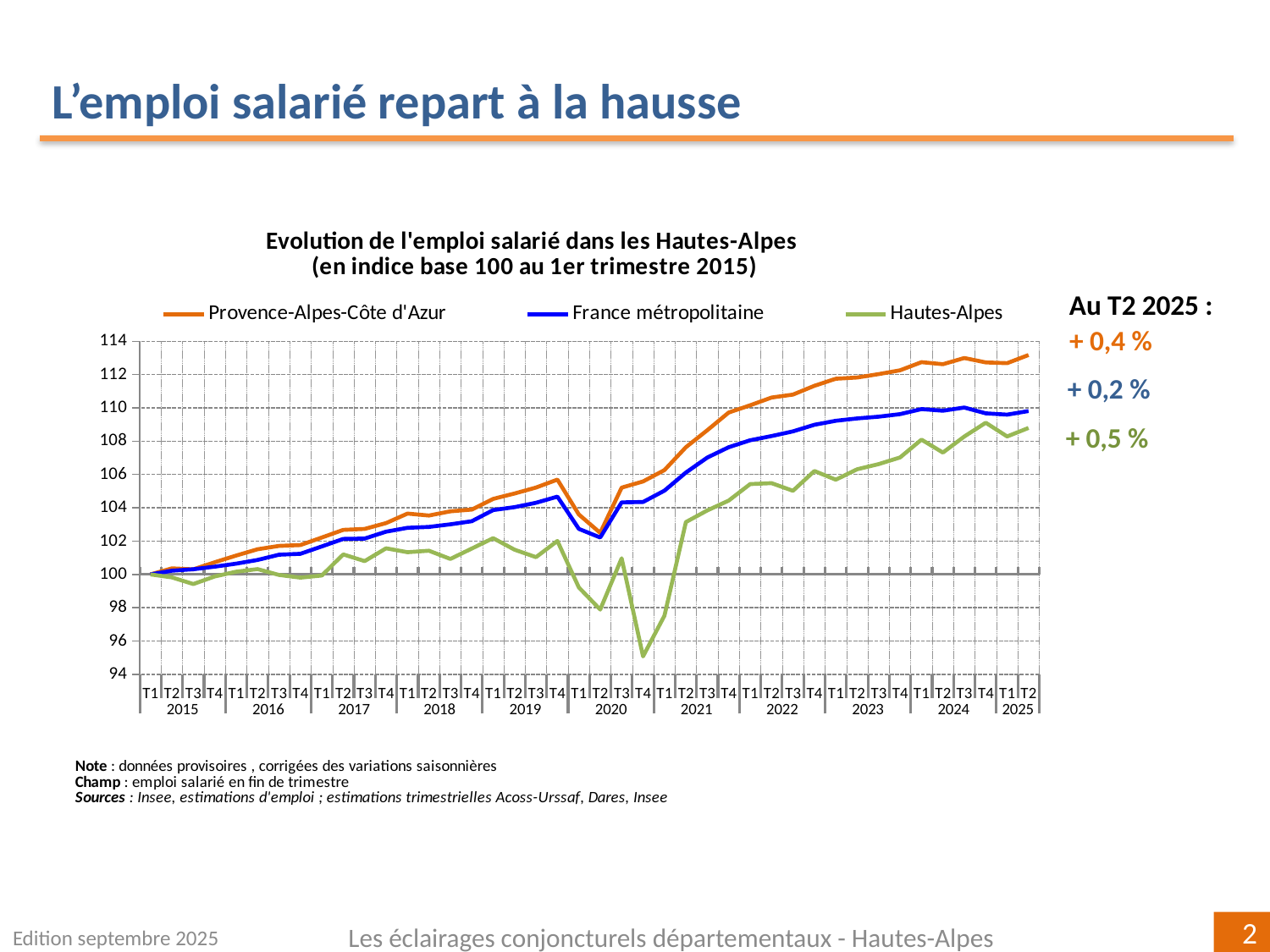
Which series are listed in the legend? Provence-Alpes-Côte d'Azur, France métropolitaine, Hautes-Alpes At T2 2025, which is larger: the value for Provence-Alpes-Côte d'Azur or the value for France métropolitaine? Provence-Alpes-Côte d'Azur What kind of chart is shown on the slide? Line chart What change is annotated for Hautes-Alpes at T2 2025? + 0,5 % Which series has the lowest value at T2 2025? Hautes-Alpes Is the value for Hautes-Alpes at T1 2020 greater or less than 100? less What is the base value of the index used in the chart, according to the title? 100 au 1er trimestre 2015 Which series has the highest value at T2 2025? Provence-Alpes-Côte d'Azur Is the value for Hautes-Alpes at T4 2020 greater or less than 96? less How many series does the legend list? 3 Is the value for Provence-Alpes-Côte d'Azur at T2 2025 greater or less than 112? greater In which quarter does the Hautes-Alpes series reach its lowest value? T4 2020